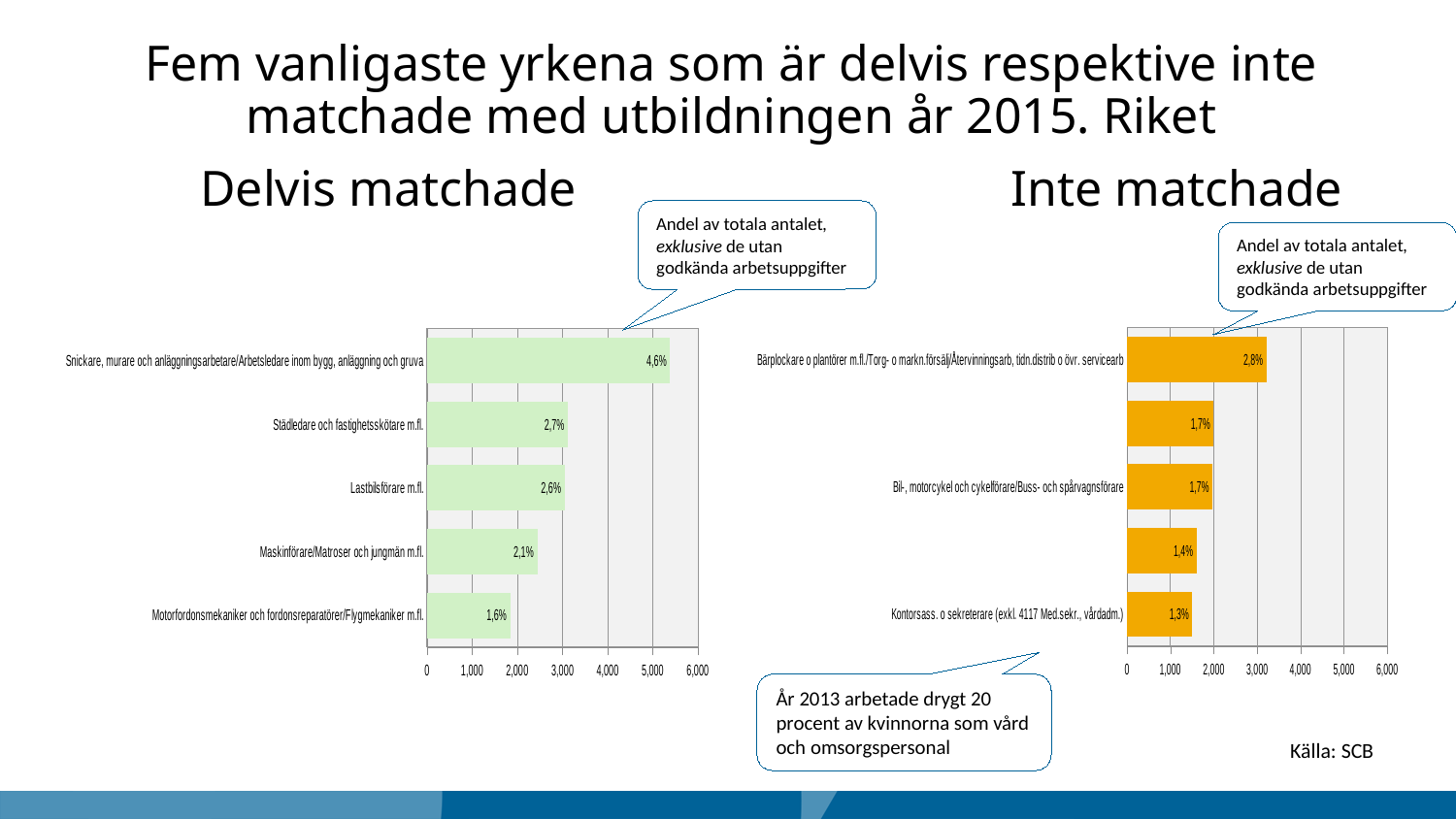
In the 'Delvis matchade' chart, which category has the highest value? Snickare, murare och anläggningsarbetare/Arbetsledare inom bygg, anläggning och gruva In the 'Inte matchade' chart, is the bar for Kontorsass. o sekreterare (exkl. 4117 Med.sekr., vårdadm.) greater or less than 2,000 on the x axis? less In the 'Inte matchade' chart, what is the data label for Kontorsass. o sekreterare (exkl. 4117 Med.sekr., vårdadm.)? 1,3% In the 'Inte matchade' chart, what is the data label for Bil-, motorcykel och cykelförare/Buss- och spårvagnsförare? 1,7% In the 'Inte matchade' chart, which is larger: the value for Bärplockare o plantörer m.fl./Torg- o markn.försälj/Återvinningsarb, tidn.distrib o övr. servicearb or the value for Kontorsass. o sekreterare (exkl. 4117 Med.sekr., vårdadm.)? Bärplockare o plantörer m.fl./Torg- o markn.försälj/Återvinningsarb, tidn.distrib o övr. servicearb In the 'Delvis matchade' chart, what is the data label for Städledare och fastighetsskötare m.fl.? 2,7% In the 'Delvis matchade' chart, which category has the lowest value? Motorfordonsmekaniker och fordonsreparatörer/Flygmekaniker m.fl. What type of chart is the 'Delvis matchade' chart? Bar chart How many bars does the 'Inte matchade' chart show? 5 In the 'Delvis matchade' chart, what is the difference between the data labels for Snickare, murare och anläggningsarbetare/Arbetsledare inom bygg, anläggning och gruva and Städledare och fastighetsskötare m.fl.? 1,9% In the 'Delvis matchade' chart, what is the data label for Lastbilsförare m.fl.? 2,6% In the 'Delvis matchade' chart, is the bar for Snickare, murare och anläggningsarbetare/Arbetsledare inom bygg, anläggning och gruva greater or less than 5,000 on the x axis? greater